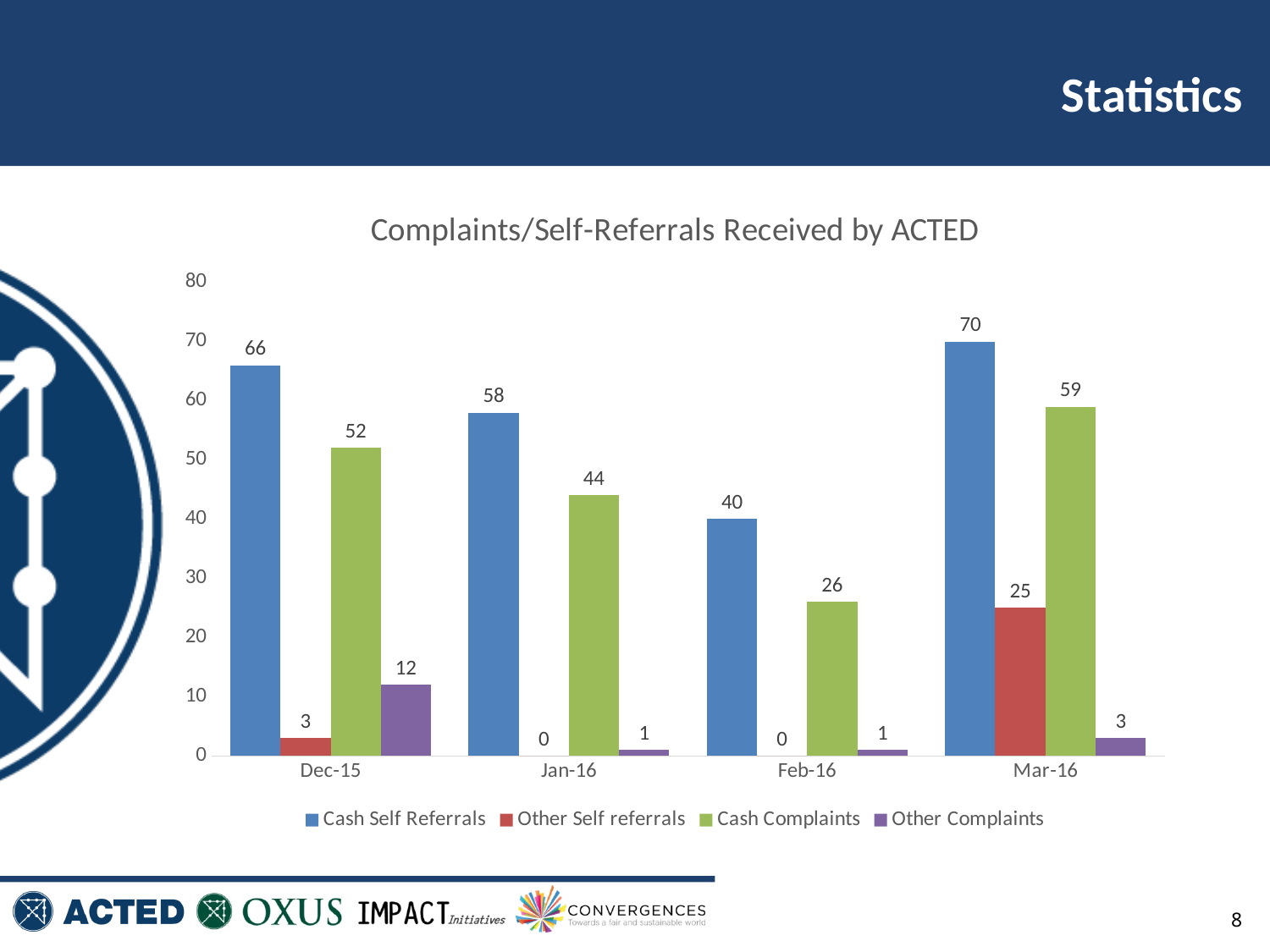
What is the value for Other Self referrals in Mar-16? 25 What is the value for Other Complaints in Dec-15? 12 What is the difference between Cash Self Referrals and Cash Complaints in Feb-16? 14 Which is larger in Jan-16: Cash Self Referrals or Cash Complaints? Cash Self Referrals How many series does the legend list? 4 In which month is the Cash Complaints value lowest? Feb-16 What is the title of the chart? Complaints/Self-Referrals Received by ACTED What is the value for Cash Self Referrals in Dec-15? 66 In which month is the Cash Self Referrals value highest? Mar-16 What kind of chart is shown on the slide? Bar chart How many months are shown on the x axis? 4 What is the value for Cash Complaints in Mar-16? 59